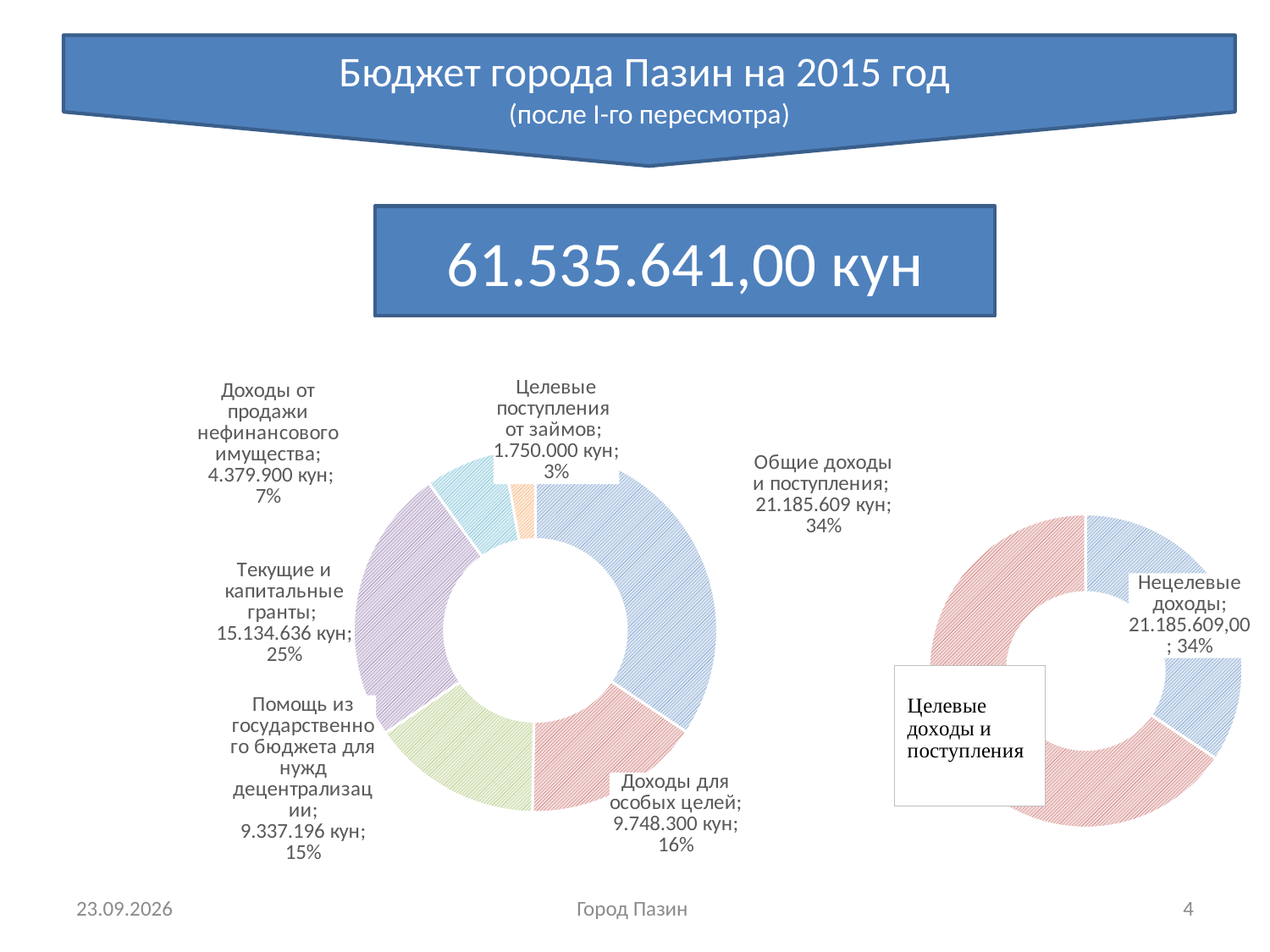
On the right doughnut chart, what percentage share is shown for Нецелевые доходы? 34% What total budget amount is shown in the box above the charts? 61.535.641,00 кун On the left doughnut chart, what percentage share is shown for Текущие и капитальные гранты? 25% On the left doughnut chart, which is larger: Помощь из государственного бюджета для нужд децентрализации or Доходы от продажи нефинансового имущества? Помощь из государственного бюджета для нужд децентрализации What type of chart is the left chart on the slide? Doughnut chart On the left doughnut chart, what is the difference in кун between Общие доходы и поступления and Доходы для особых целей? 11.437.309 кун How many categories are shown on the left doughnut chart? 6 On the left doughnut chart, what is the value for Общие доходы и поступления? 21.185.609 кун On the left doughnut chart, what is the value for Целевые поступления от займов? 1.750.000 кун On the left doughnut chart, which category has the largest value? Общие доходы и поступления On the left doughnut chart, which category has the smallest value? Целевые поступления от займов How many segments does the right doughnut chart have? 2